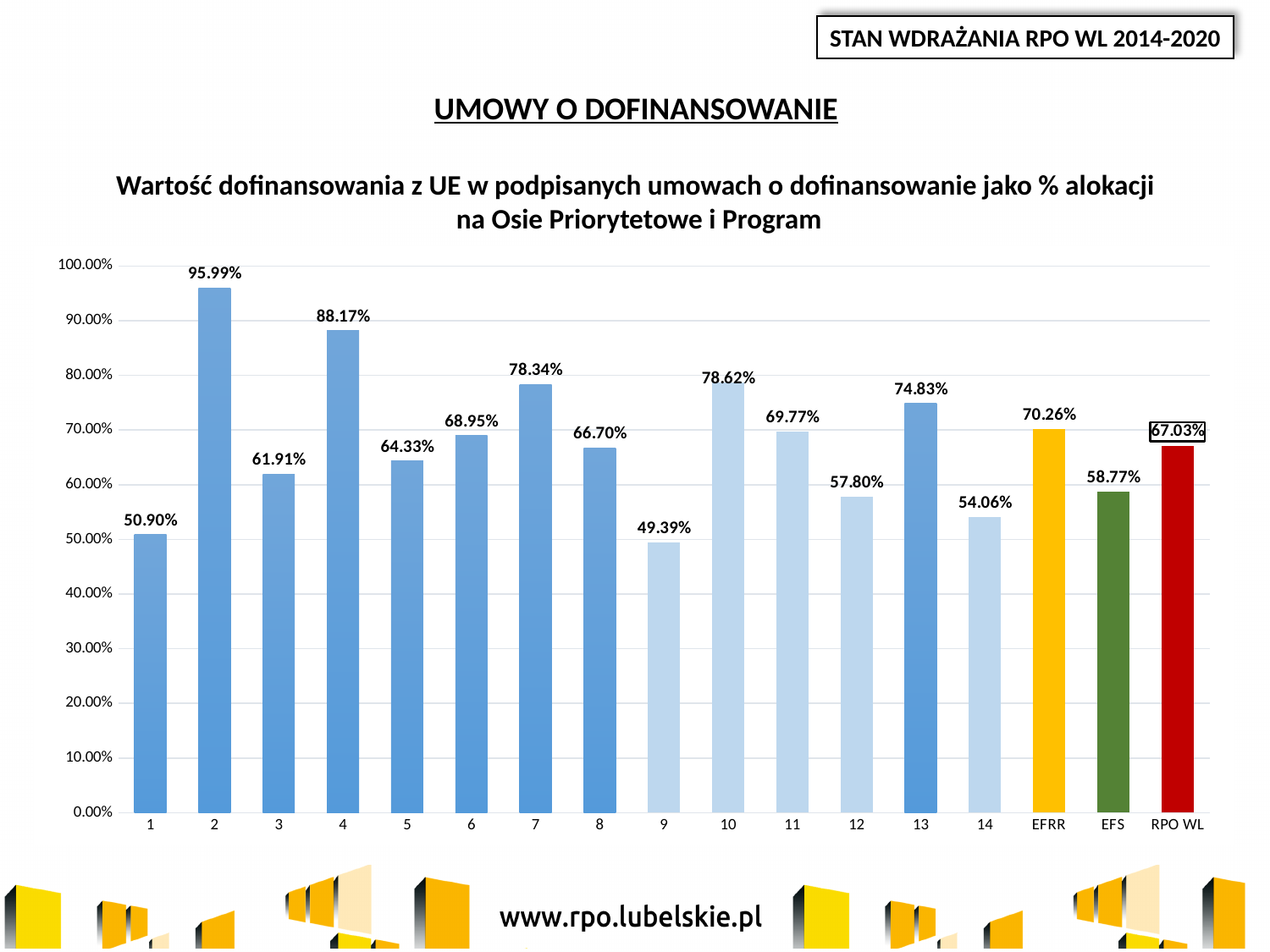
What is the value for category 2? 95.99% Which category has the lowest value? 9 Which category has the highest value? 2 Which is larger, the value for EFRR or the value for EFS? EFRR What is the difference between the values for category 4 and category 3? 26.26% What is the value for category 14? 54.06% What is the value for RPO WL? 67.03% How many categories are shown on the x axis? 17 What colour is the bar for RPO WL? red What is the value for EFRR? 70.26% What kind of chart is shown on the slide? bar chart Is the value for category 13 greater or less than 70.00%? greater